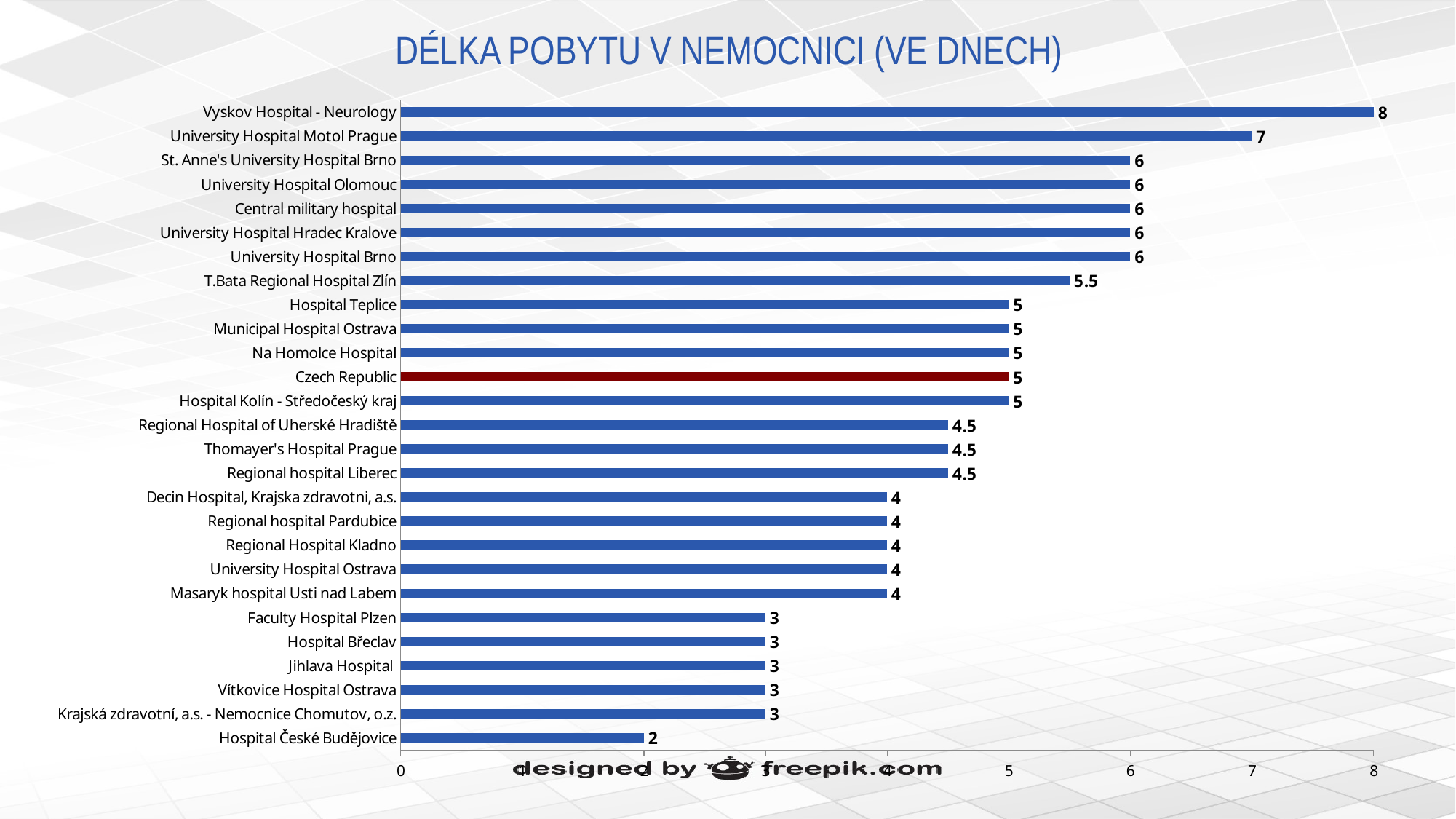
Which category has the lowest value? Hospital České Budějovice How many categories are shown in the chart? 27 What is the difference between the values for Vyskov Hospital - Neurology and Czech Republic? 3 What is the difference between the values for University Hospital Motol Prague and Hospital České Budějovice? 5 What kind of chart is shown on the slide? Bar chart Which category has the highest value? Vyskov Hospital - Neurology What is the title of the chart? DÉLKA POBYTU V NEMOCNICI (VE DNECH) Which is larger, the value for Faculty Hospital Plzen or the value for Regional Hospital Kladno? Regional Hospital Kladno What is the value for T.Bata Regional Hospital Zlín? 5.5 What is the value for Czech Republic? 5 What is the value for Vyskov Hospital - Neurology? 8 What is the value for Regional hospital Liberec? 4.5